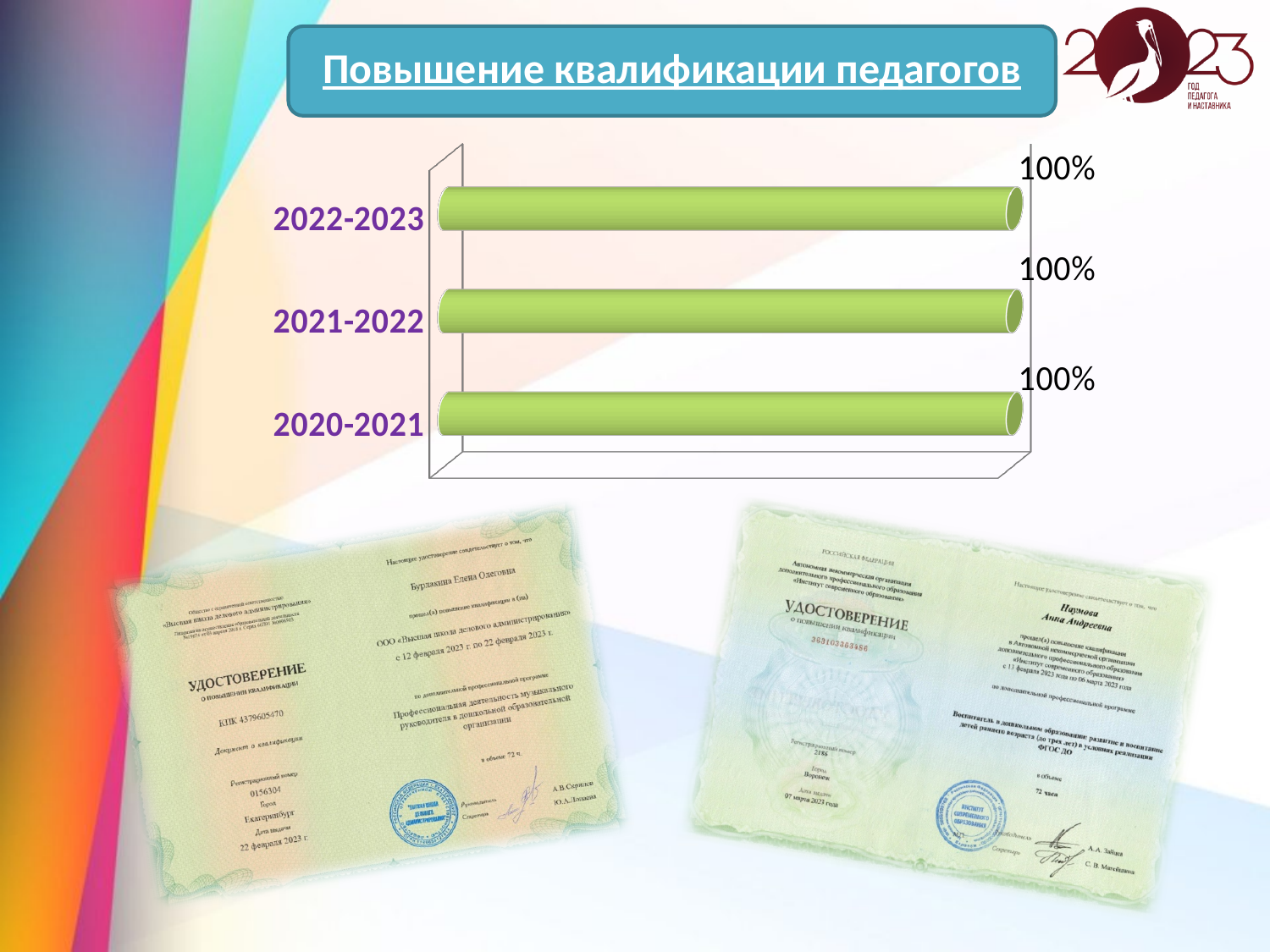
What is the value for 2021-2022? 100% What is the difference between the values for 2022-2023 and 2020-2021? 0% What is the value for 2022-2023? 100% What is the title of the slide containing the chart? Повышение квалификации педагогов Do the values change from 2020-2021 to 2022-2023? No, they stay at 100% Is the value for 2021-2022 greater or less than 50%? greater How many categories are shown in the chart? 3 Which category is listed at the top of the chart? 2022-2023 What kind of chart is shown on the slide? bar chart What is the value for 2020-2021? 100% What colour are the bars in the chart? green